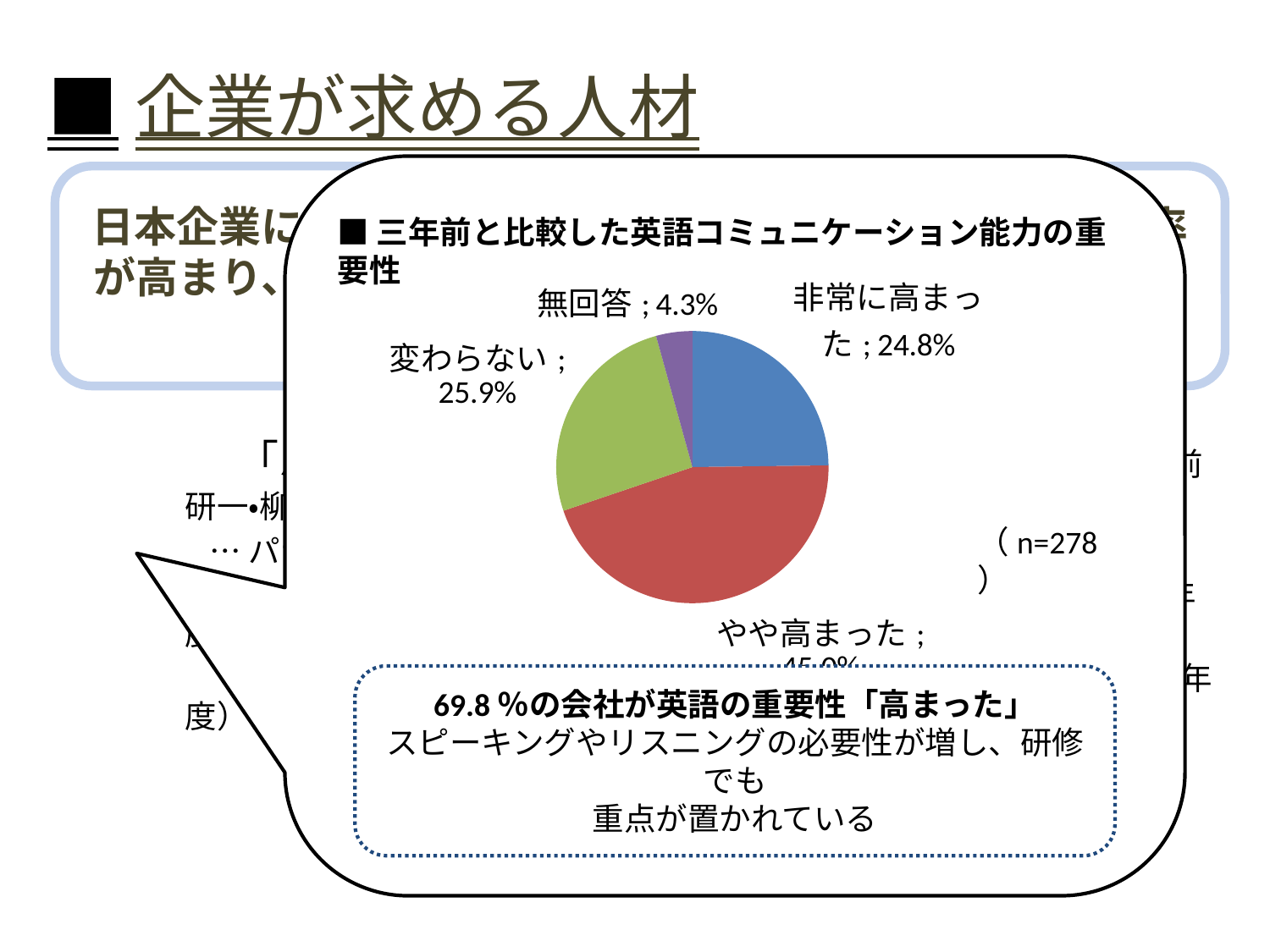
Which category has the smallest slice in the pie chart? 無回答 What is the difference in percentage points between 非常に高まった and 無回答? 20.5 What is the title of the pie chart? 三年前と比較した英語コミュニケーション能力の重要性 Which category has the largest slice in the pie chart? やや高まった What kind of chart is shown on the slide? pie chart What percentage of the pie chart is labelled 変わらない? 25.9% What percentage of the pie chart is labelled 無回答? 4.3% Which is larger in the pie chart, 変わらない or 非常に高まった? 変わらない What is the difference in percentage points between 変わらない and 非常に高まった? 1.1 What sample size (n) is shown next to the pie chart? n=278 What percentage of the pie chart is labelled 非常に高まった? 24.8% How many slices does the pie chart have? 4